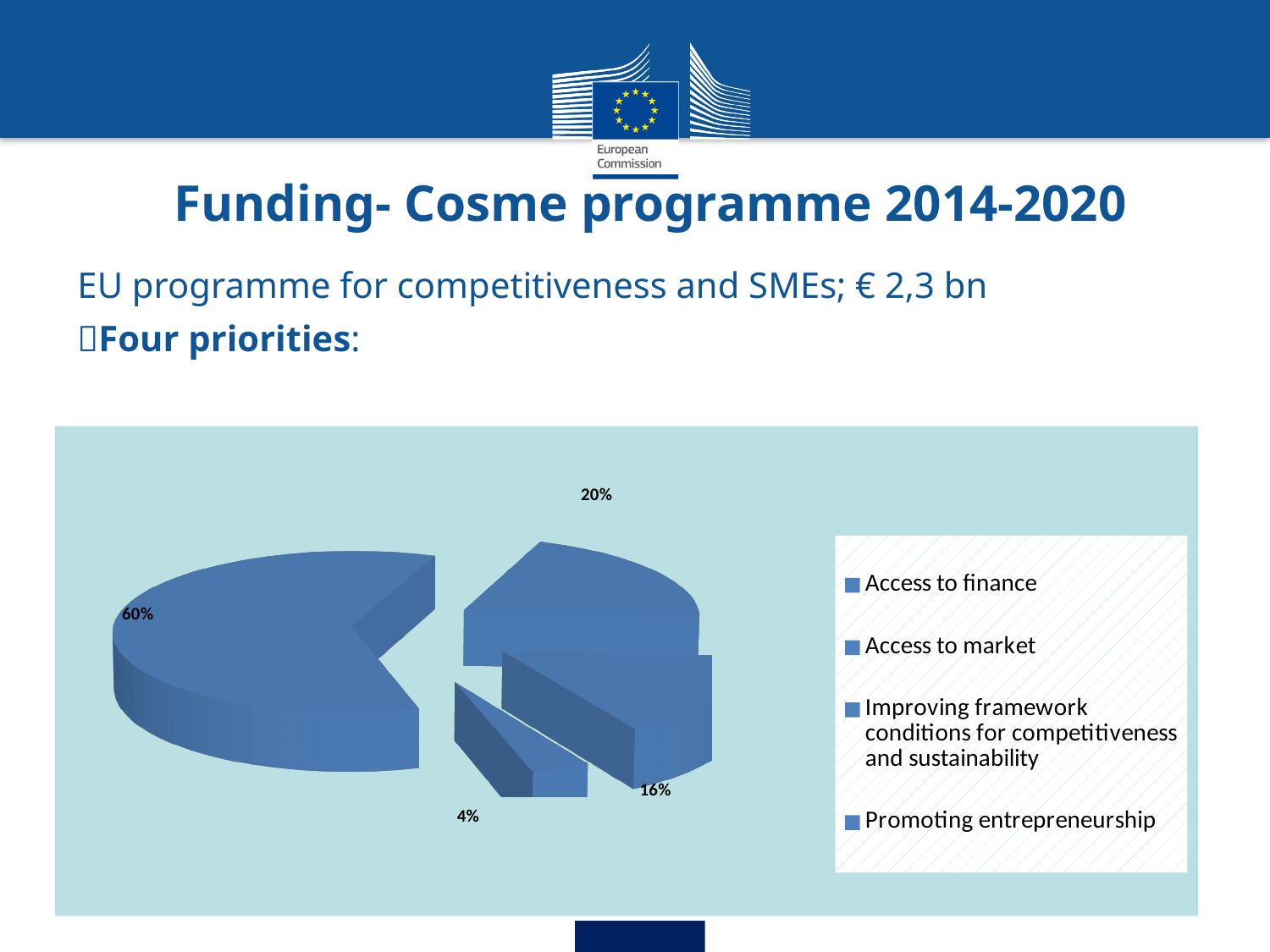
What is the percentage shown on the largest slice of the pie chart? 60% Which legend entry of the pie chart is listed first? Access to finance What is the percentage shown on the smallest slice of the pie chart? 4% What kind of chart is shown on the slide? pie chart How many slices does the pie chart have? 4 What do the four percentage labels on the pie chart add up to? 100% What is the difference in percentage points between the largest slice (60%) and the smallest slice (4%) of the pie chart? 56 Which is larger in the pie chart: the slice labelled 20% or the slice labelled 16%? the 20% slice How many entries does the legend of the pie chart list? 4 Which legend entry of the pie chart is listed last? Promoting entrepreneurship What is the difference in percentage points between the 20% slice and the 16% slice of the pie chart? 4